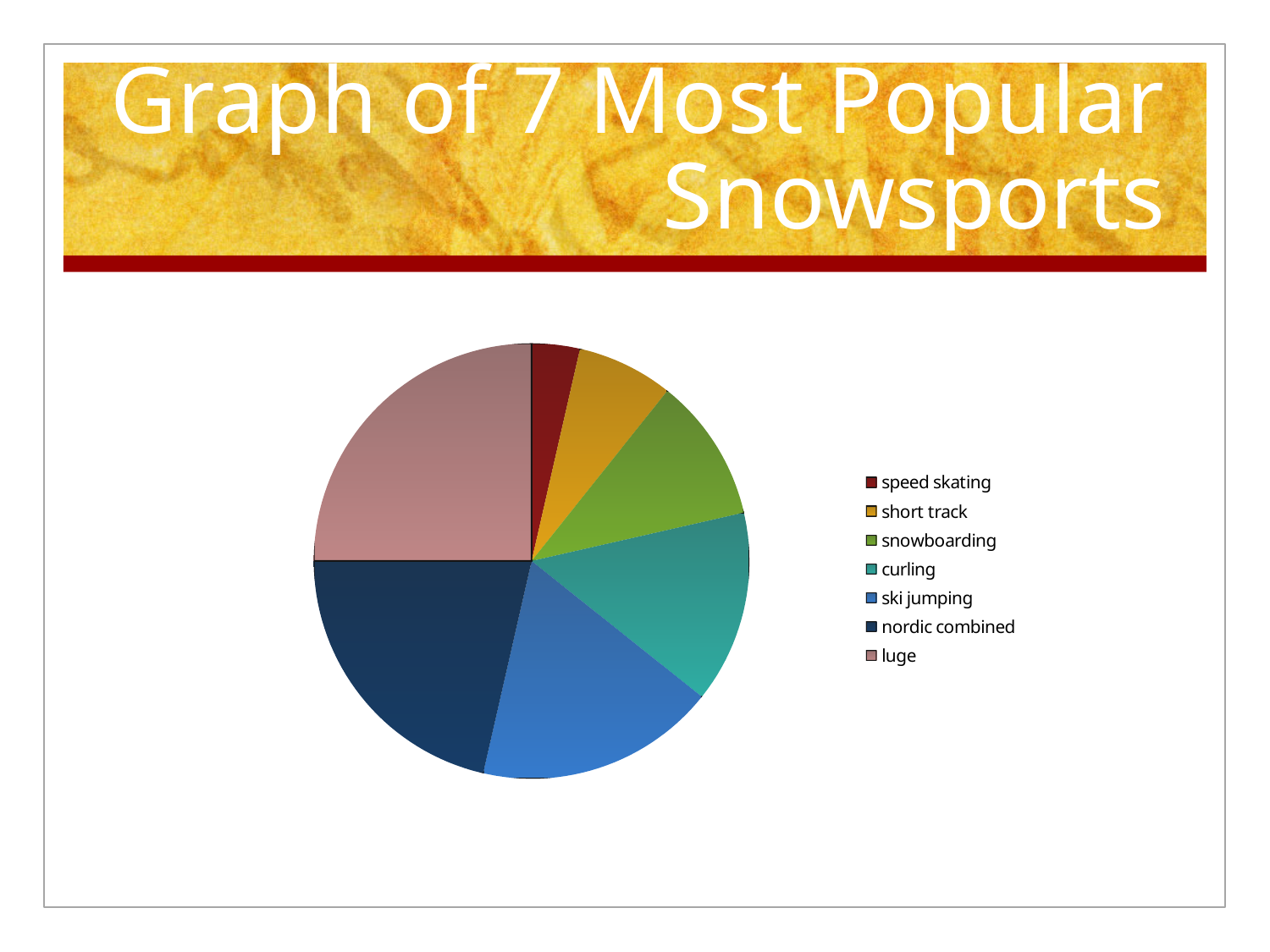
Which slice is larger, curling or snowboarding? curling Which slice is larger, nordic combined or short track? nordic combined How many slices does the pie chart have? 7 Which snowsport has the smallest slice of the pie chart? speed skating What kind of chart is shown on the slide? pie chart What is the title of the slide containing the pie chart? Graph of 7 Most Popular Snowsports How many entries does the legend of the pie chart list? 7 Which snowsport has the largest slice of the pie chart? luge Which slice is larger, ski jumping or speed skating? ski jumping Which legend entry is listed first in the pie chart's legend? speed skating